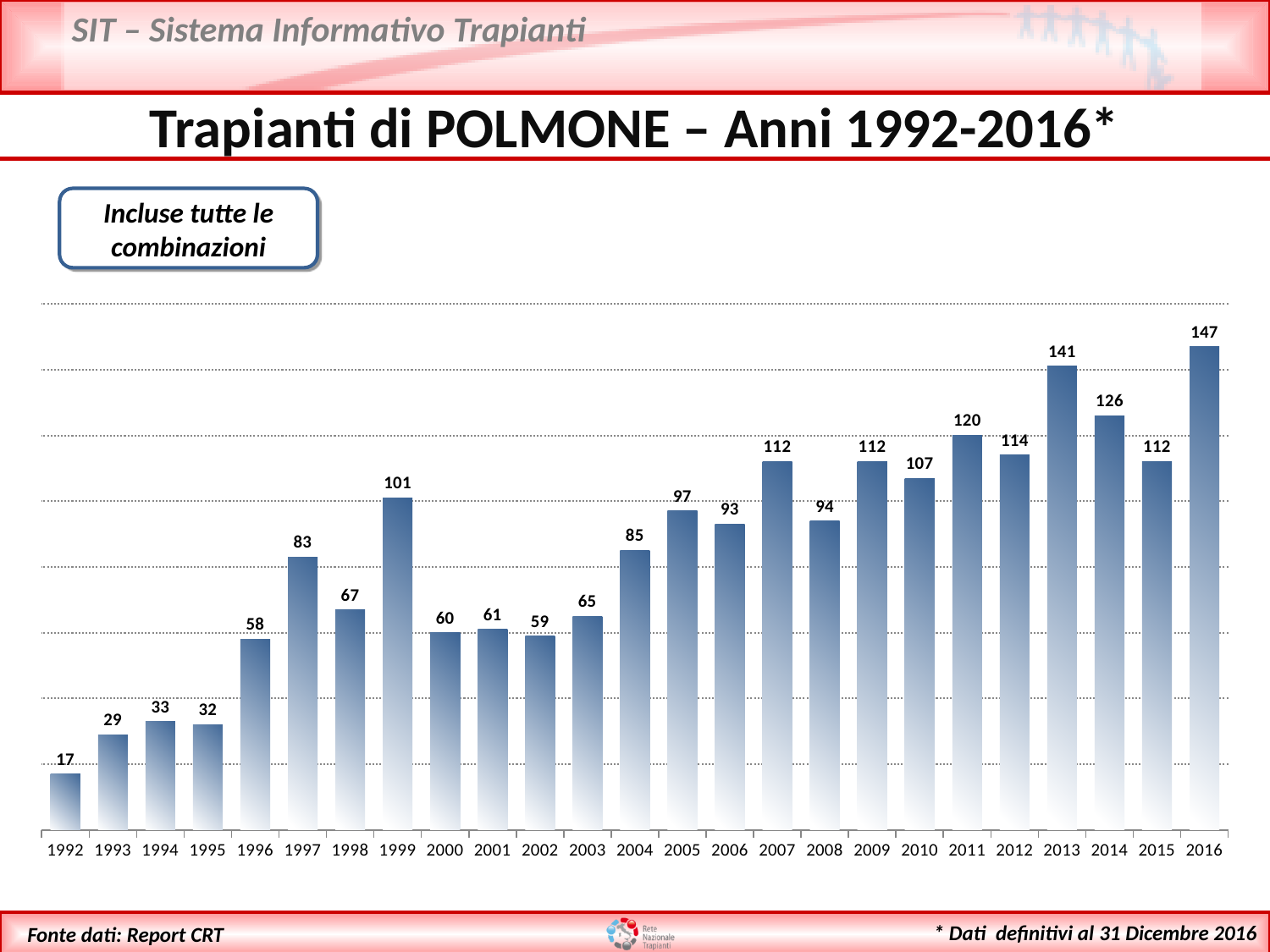
Which is larger, the value for 2011 or the value for 2012? 2011 Which year has the highest value? 2016 What is the difference between the values for 2016 and 2015? 35 Which year has the lowest value? 1992 What is the value for 2013? 141 Do the values generally rise or fall from 1992 to 2016? rise What is the value for 1992? 17 What is the title of the slide containing the chart? Trapianti di POLMONE – Anni 1992-2016* How many years are shown on the x axis? 25 What is the value for 1999? 101 What is the difference between the values for 1997 and 1998? 16 What kind of chart is shown on the slide? bar chart